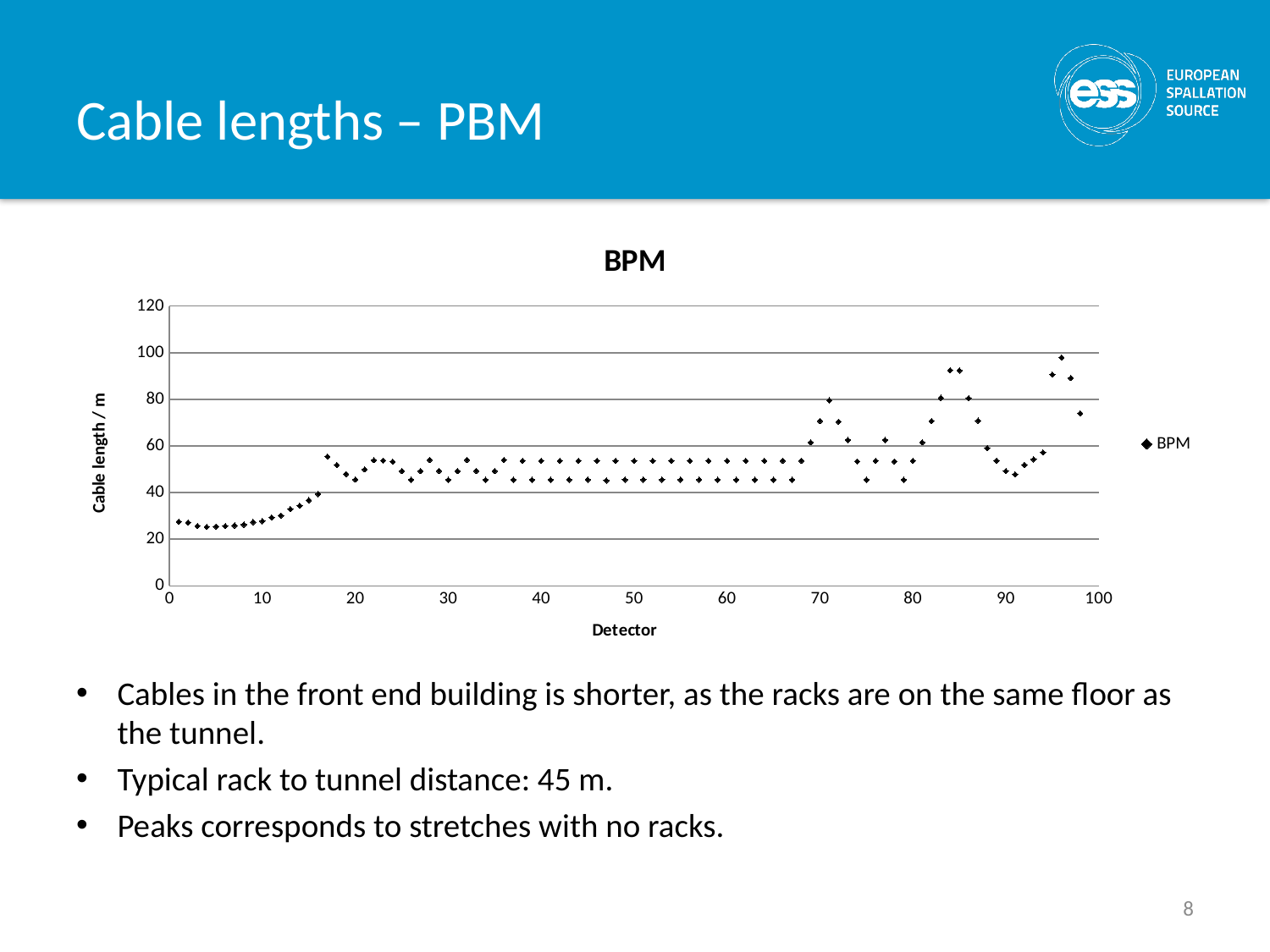
What kind of chart is shown on the slide? Scatter chart Is the highest cable length plotted on the chart greater or less than 80? greater Is the cable length for detector 71 greater or less than 60? greater How many series does the chart legend list? 1 What is the label of the y axis of the chart? Cable length / m Do the cable lengths rise or fall between detector 10 and detector 17? rise What is the title of the chart? BPM Is the cable length for detector 96 greater or less than 80? greater Which has the larger cable length, detector 1 or detector 96? Detector 96